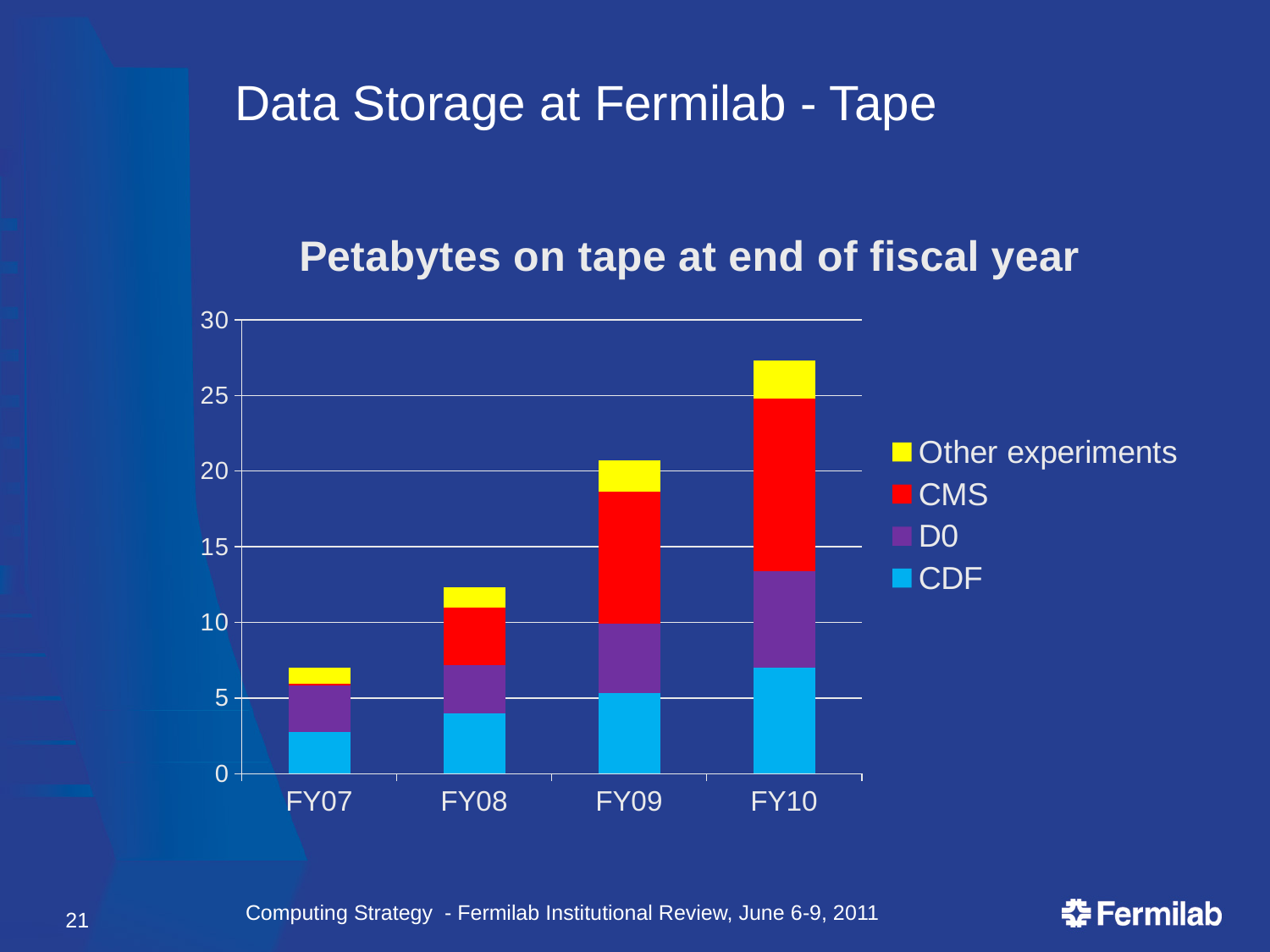
Is the CDF value for FY10 greater or less than 5? greater How many fiscal years are shown on the x axis of the chart? 4 Which fiscal year has the highest total petabytes on tape? FY10 Is the total petabytes on tape for FY07 greater or less than 10? less Do the total petabytes on tape rise or fall from FY07 to FY10? Rise Which has the larger total petabytes on tape, FY08 or FY09? FY09 What is the title of the chart? Petabytes on tape at end of fiscal year What kind of chart is shown on the slide? Stacked bar chart Which fiscal year has the lowest total petabytes on tape? FY07 Is the total petabytes on tape for FY10 greater or less than 25? greater How many series does the chart's legend list? 4